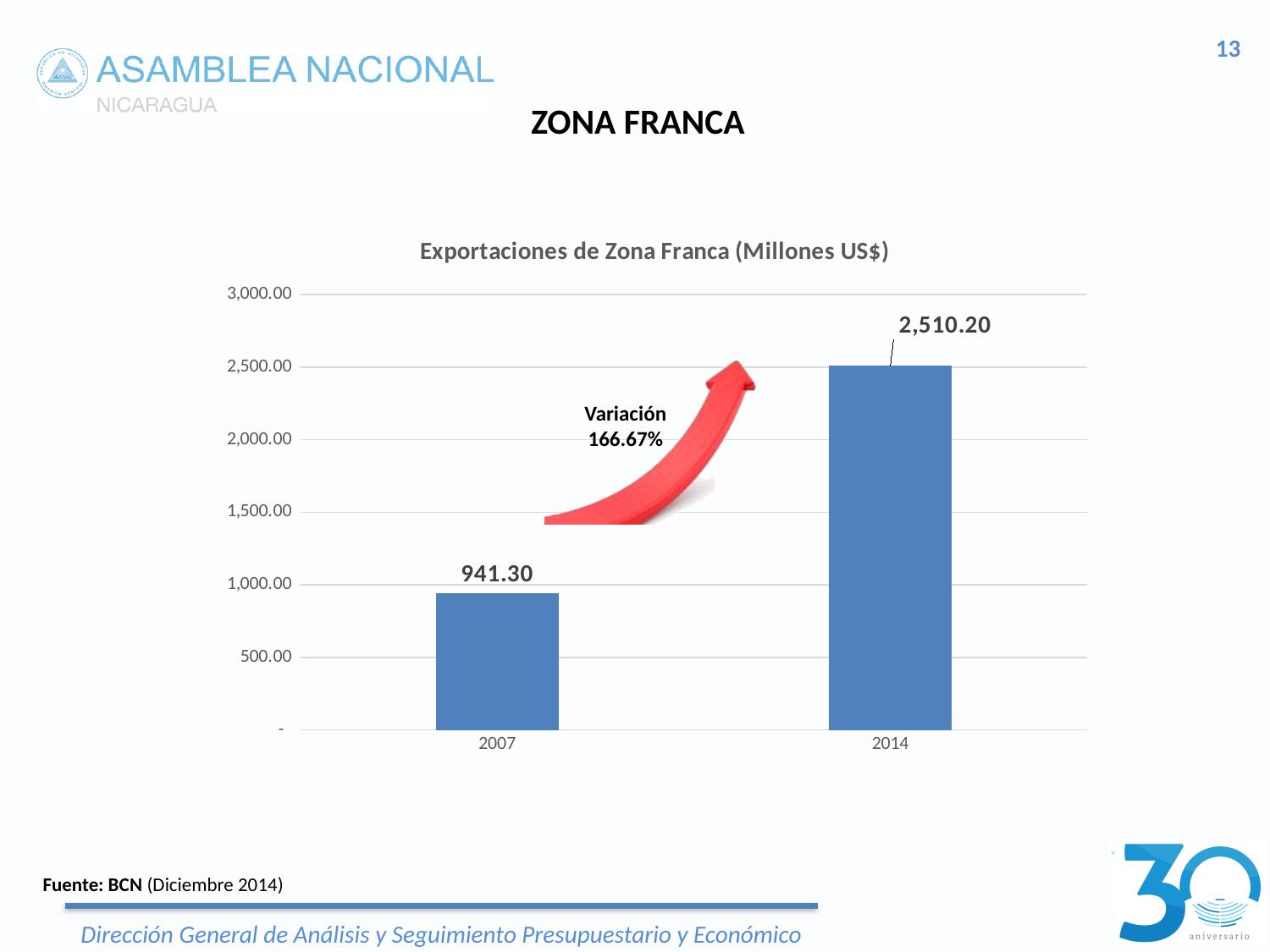
How many years are shown on the x axis of the chart? 2 What kind of chart is shown on the slide? bar chart What is the difference between the 2014 and 2007 export values? 1,568.90 Do the export values rise or fall from 2007 to 2014? rise What is the value for 2014 in the Exportaciones de Zona Franca chart? 2,510.20 Which is larger, the value for 2007 or the value for 2014? 2014 Is the value for 2007 greater or less than 1,000.00? less What is the value for 2007 in the Exportaciones de Zona Franca chart? 941.30 Which year has the highest export value in the chart? 2014 Is the value for 2014 greater or less than 2,500.00? greater Which year has the lowest export value in the chart? 2007 What is the title of the chart? Exportaciones de Zona Franca (Millones US$)